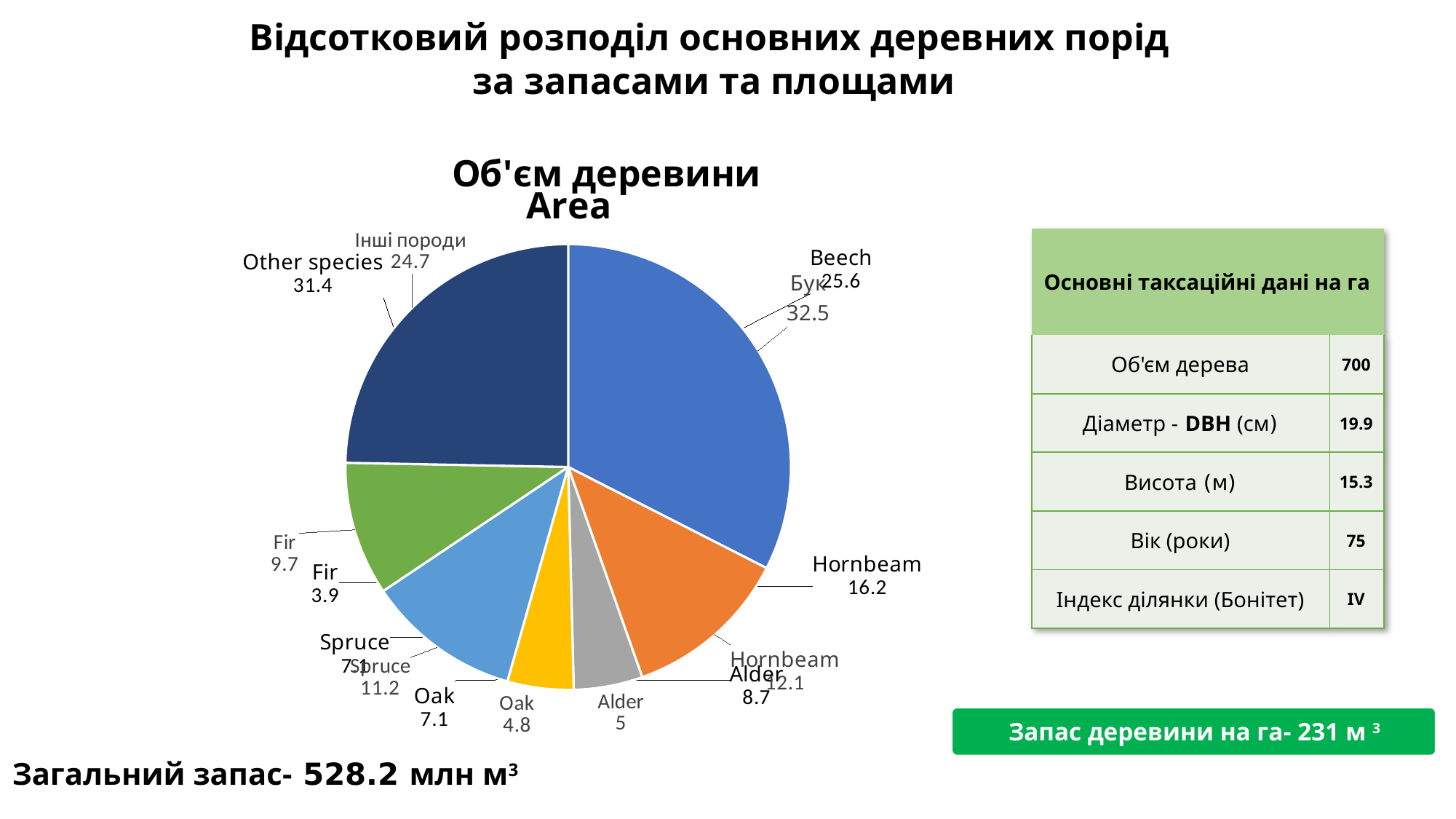
What value is printed next to the label "Бук" on the pie chart? 32.5 Two values are printed for Fir on the pie chart, 9.7 and 3.9. What is the difference between them? 5.8 What value is printed next to the label "Beech" on the pie chart? 25.6 Which slice is larger in the pie chart, Spruce or Oak? Spruce Which species has the largest slice in the pie chart? Beech What colour is the largest slice of the pie chart? blue What value is printed next to the grey "Spruce" label on the pie chart? 11.2 What value is printed next to the label "Other species" on the pie chart? 31.4 What type of chart is shown on the slide? pie chart Which of the two values printed for Hornbeam on the pie chart is larger, 16.2 or 12.1? 16.2 What value is printed next to the label "Інші породи" on the pie chart? 24.7 How many slices does the pie chart have? 7